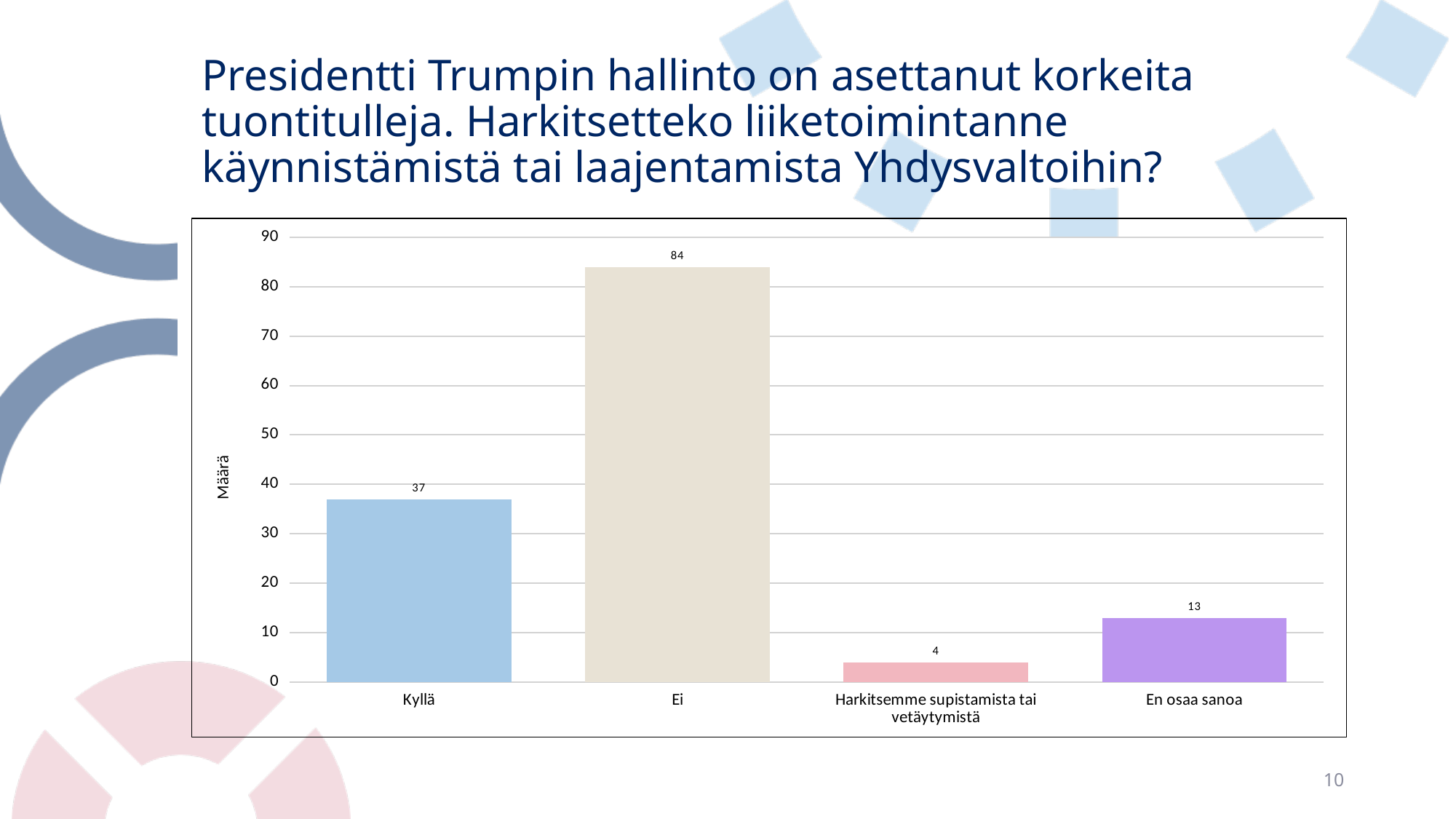
What is the value for Kyllä? 37 What kind of chart is shown on the slide? bar chart Which is larger, the value for Kyllä or the value for En osaa sanoa? Kyllä Which category has the lowest value? Harkitsemme supistamista tai vetäytymistä Which category has the highest value? Ei How many categories are shown on the x axis? 4 Is the value for Ei greater or less than 80? greater What is the difference between the values for Ei and Kyllä? 47 What is the value for Ei? 84 What is the value for En osaa sanoa? 13 What is the value for Harkitsemme supistamista tai vetäytymistä? 4 What is the label of the vertical axis? Määrä